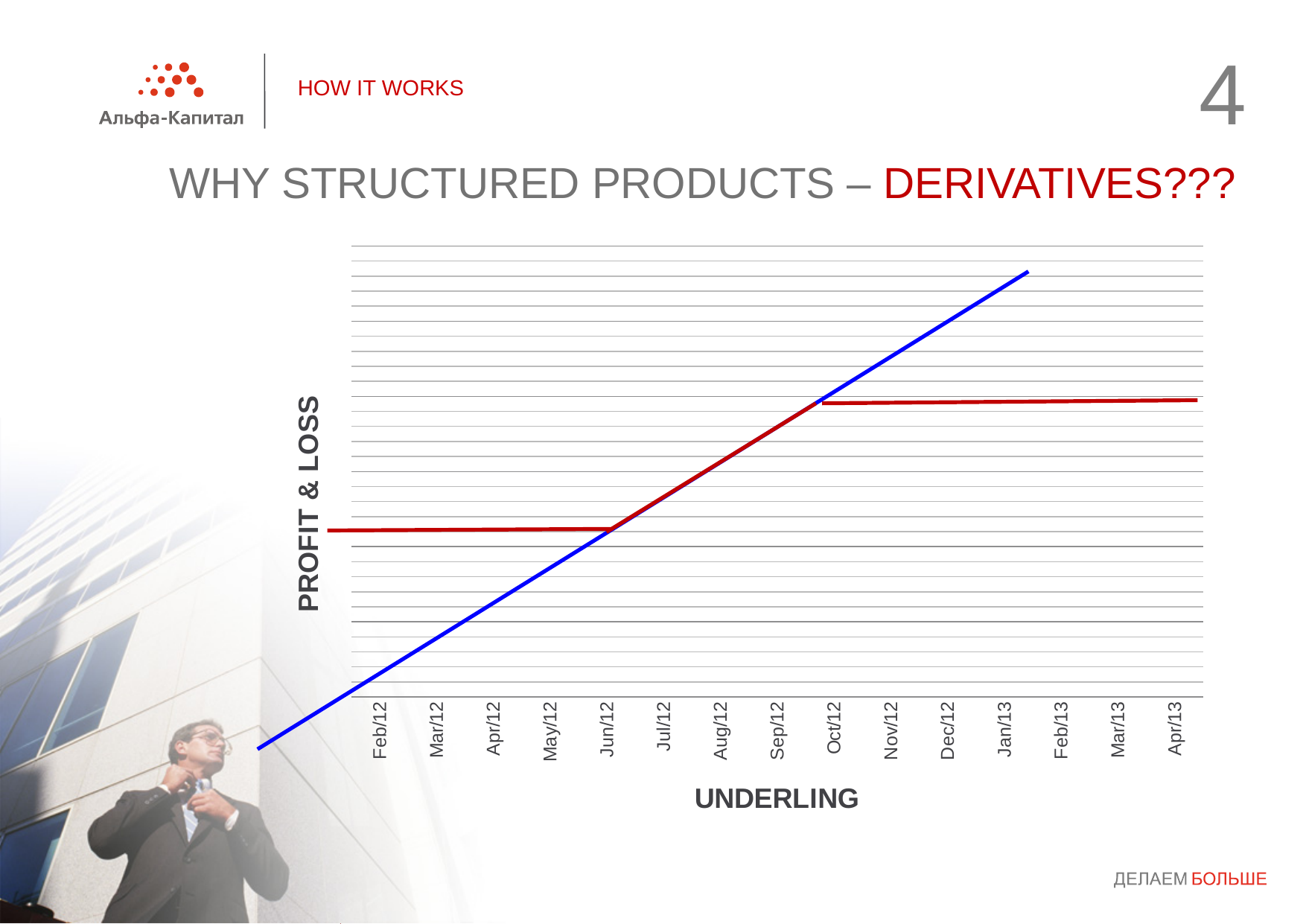
What kind of chart is shown on the slide? line chart What is the title of the vertical axis? PROFIT & LOSS What is the title of the horizontal axis? UNDERLING What is the first category labelled on the x axis? Feb/12 At Jan/13, which line is higher, the blue line or the red line? blue line Does the blue line rise or fall as you move from left to right along the x axis? rise Between Jun/12 and Sep/12, does the red line rise, fall, or stay flat? rise At Feb/12, which line is higher, the blue line or the red line? red line What is the last category labelled on the x axis? Apr/13 Between Nov/12 and Apr/13, does the red line rise, fall, or stay flat? stay flat How many categories are labelled on the x axis of the chart? 15